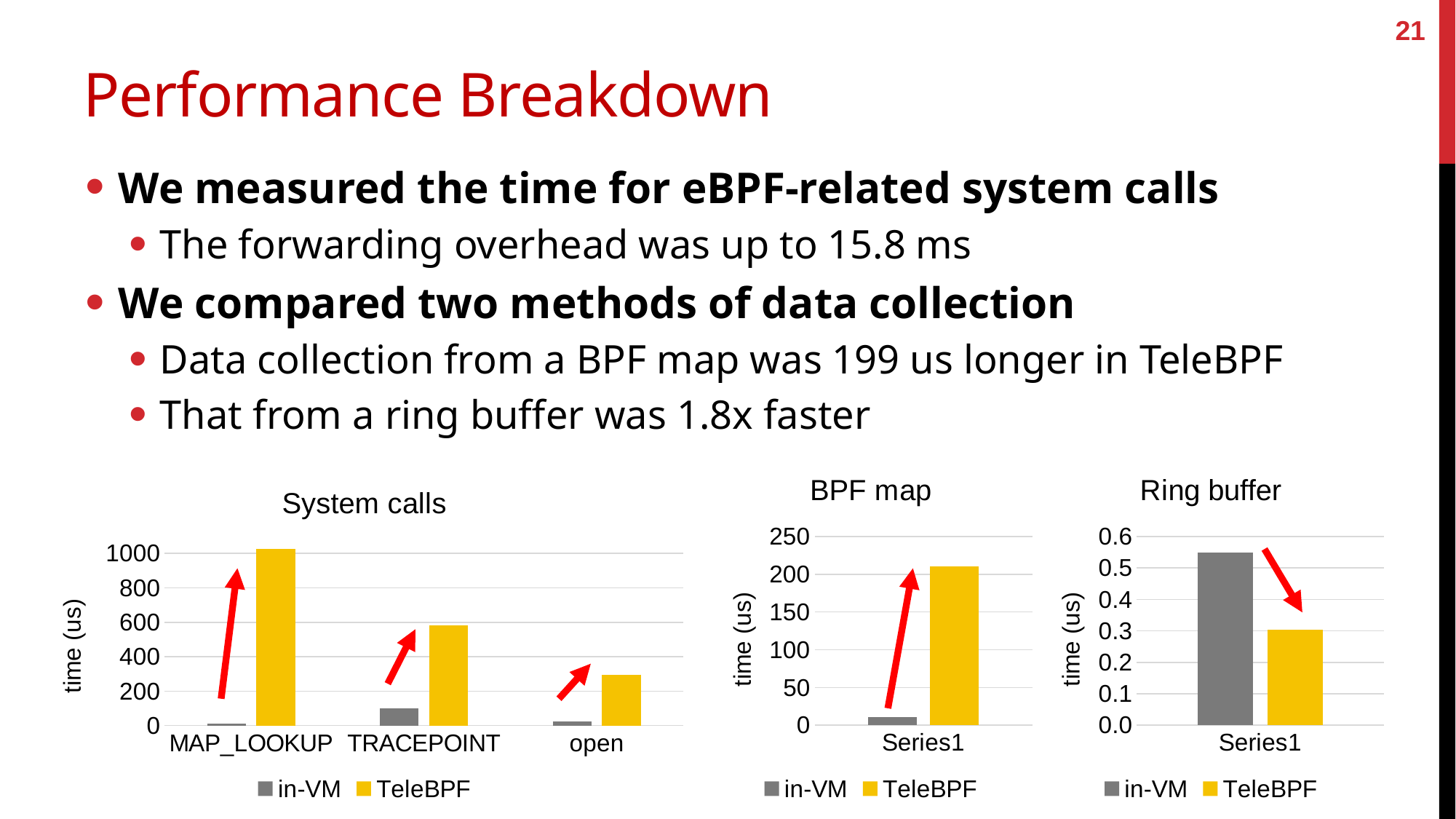
In the "System calls" chart, is the in-VM value for TRACEPOINT greater or less than 200? less In the "System calls" chart, is the TeleBPF value for open greater or less than 400? less In the "BPF map" chart, which series has the larger value, in-VM or TeleBPF? TeleBPF What is the y-axis label of the "Ring buffer" chart? time (us) In the "System calls" chart, which category has the highest TeleBPF bar? MAP_LOOKUP In the "Ring buffer" chart, which series has the larger value, in-VM or TeleBPF? in-VM In the "Ring buffer" chart, is the in-VM value greater or less than 0.5? greater What kind of chart is the "System calls" chart? bar chart How many categories are shown on the x axis of the "System calls" chart? 3 How many series does the legend of the "BPF map" chart list? 2